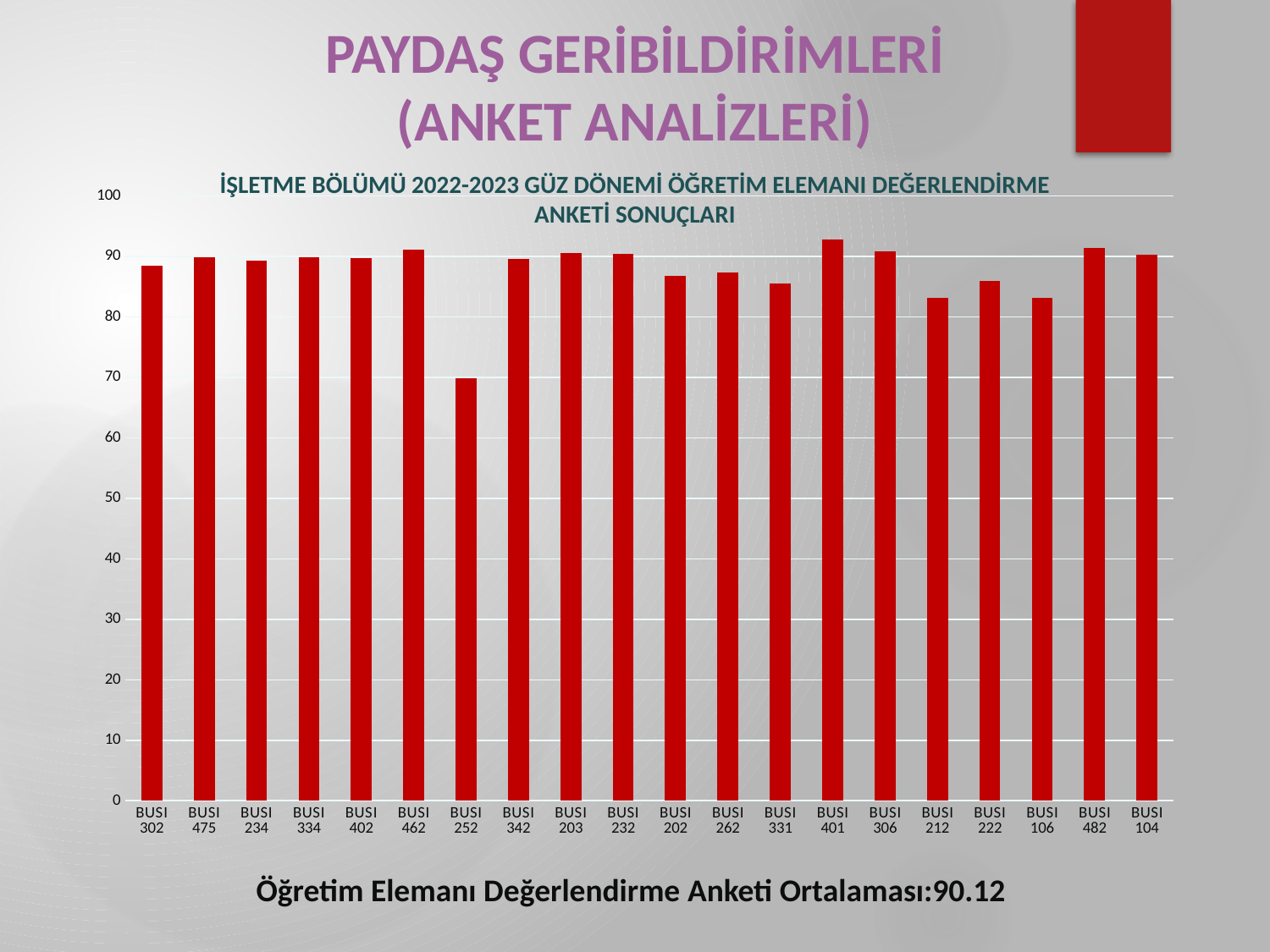
Is the value for BUSI 252 greater or less than 80? less What is the title of the chart? İŞLETME BÖLÜMÜ 2022-2023 GÜZ DÖNEMİ ÖĞRETİM ELEMANI DEĞERLENDİRME ANKETİ SONUÇLARI Is the value for BUSI 401 greater or less than 90? greater How many courses (categories) are plotted in the chart? 20 Which has a larger value, BUSI 462 or BUSI 106? BUSI 462 Which course has the highest value in the chart? BUSI 401 What kind of chart is shown on the slide? Bar chart Which course has the lowest value in the chart? BUSI 252 Which has a larger value, BUSI 302 or BUSI 252? BUSI 302 What colour are the bars in the chart? Red Is the value for BUSI 212 greater or less than 80? greater